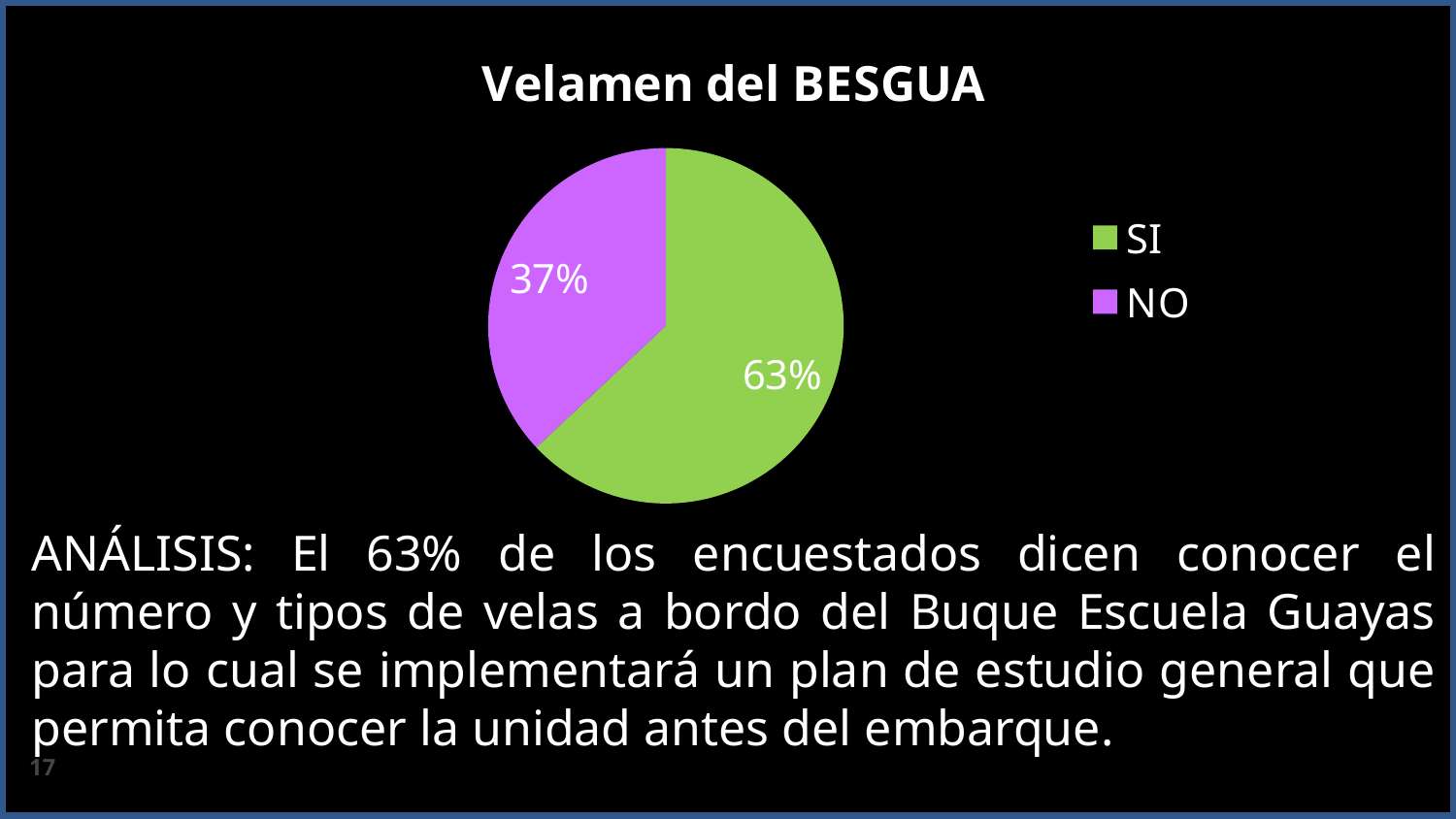
What colour represents the NO slice in the pie chart? Purple How many entries does the legend list? 2 How many slices does the pie chart have? 2 What share of the pie does the SI slice represent? 63% What type of chart is shown on the slide? Pie chart What percentage of the pie chart corresponds to SI? 63% What is the title of the chart? Velamen del BESGUA Which slice is larger, SI or NO? SI Which category has the smallest share of the pie chart? NO Which category has the largest share of the pie chart? SI What percentage of the pie chart corresponds to NO? 37% What is the difference in percentage points between the SI and NO slices? 26